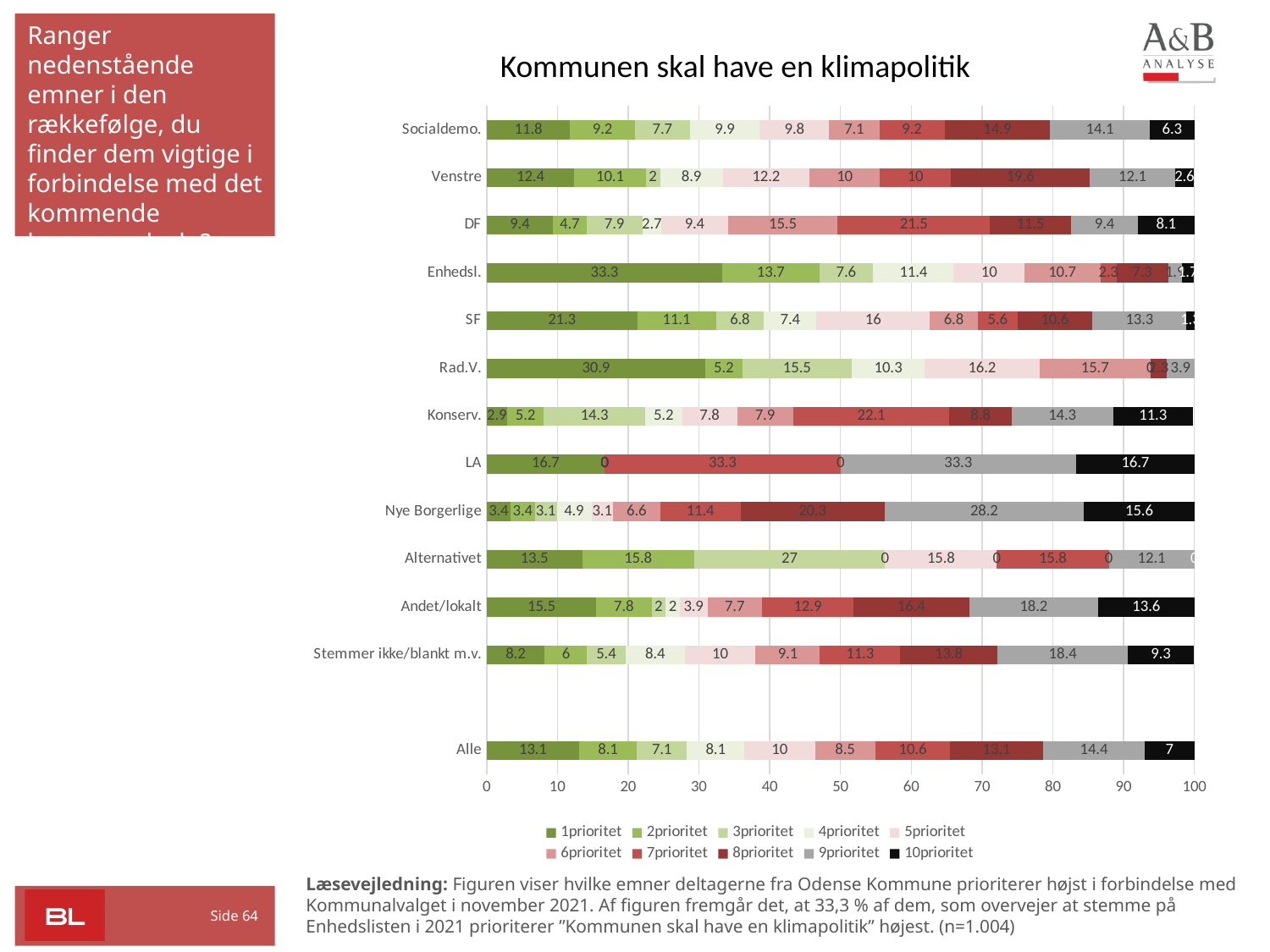
What is the 1prioritet value for Enhedsl.? 33.3 What is the 7prioritet value for DF? 21.5 For Alle, what is the difference between the 1prioritet value and the 10prioritet value? 6.1 How many categories are plotted on the y axis? 13 What is the 1prioritet value for Alle? 13.1 Which category has the highest 1prioritet value? Enhedsl. What is the 10prioritet value for Konserv.? 11.3 What is the title of the chart? Kommunen skal have en klimapolitik What kind of chart is shown on the slide? Stacked bar chart What is the 9prioritet value for Nye Borgerlige? 28.2 How many series does the legend list? 10 Which has the larger 1prioritet value, Socialdemo. or Venstre? Venstre